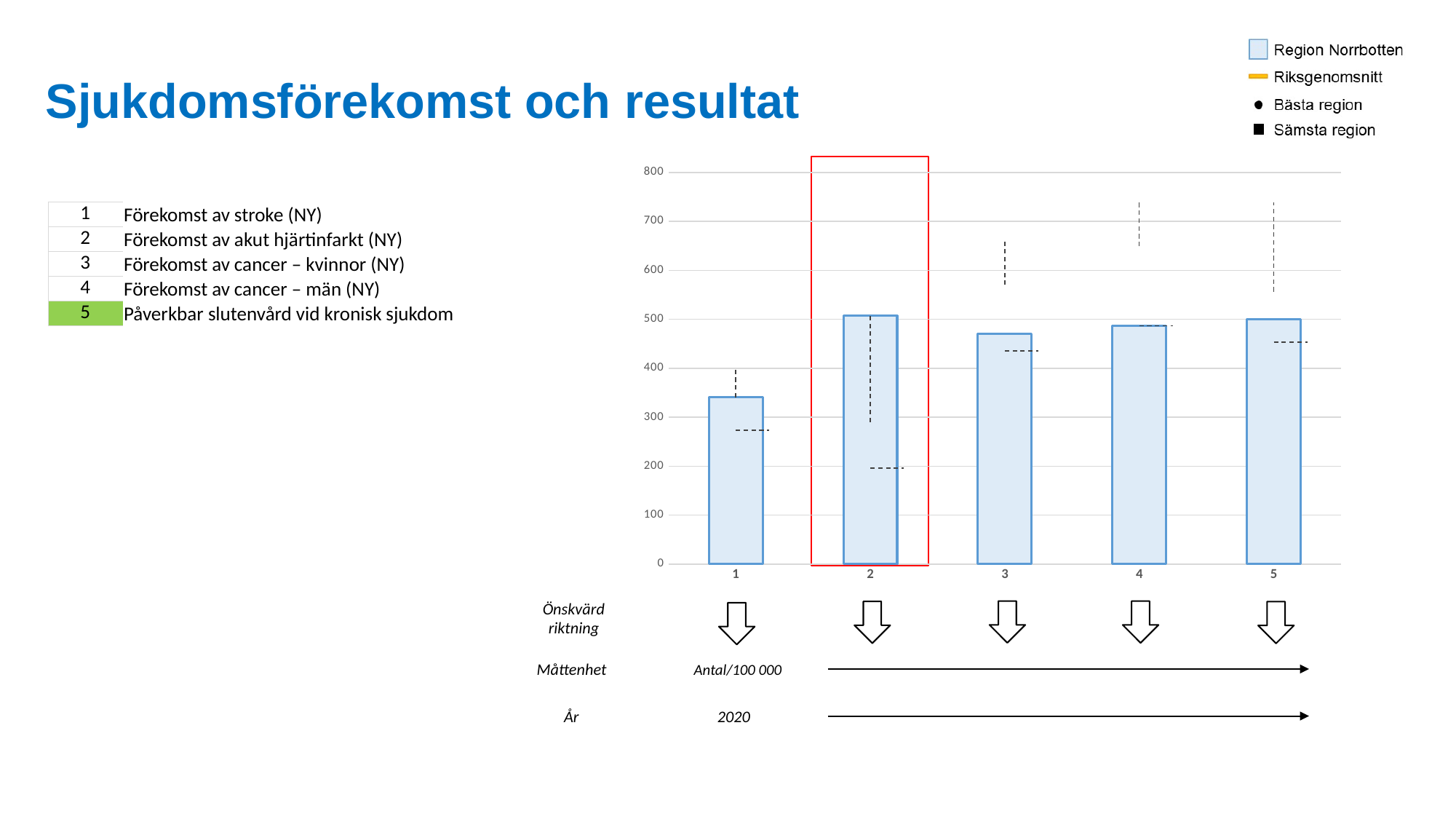
Is the value for category 3 greater or less than 500? less Which category on the chart is outlined with a red box? 2 Which category has the lowest bar in the chart? 1 Which bar is taller, category 1 or category 3? 3 What is the title of the slide containing the chart? Sjukdomsförekomst och resultat How many categories are plotted on the x axis of the chart? 5 Is the value for category 1 greater or less than 300? greater What kind of chart is shown on the slide? bar chart Which bar is taller, category 1 or category 2? 2 Is the value for category 1 greater or less than 400? less How many entries does the chart legend list? 4